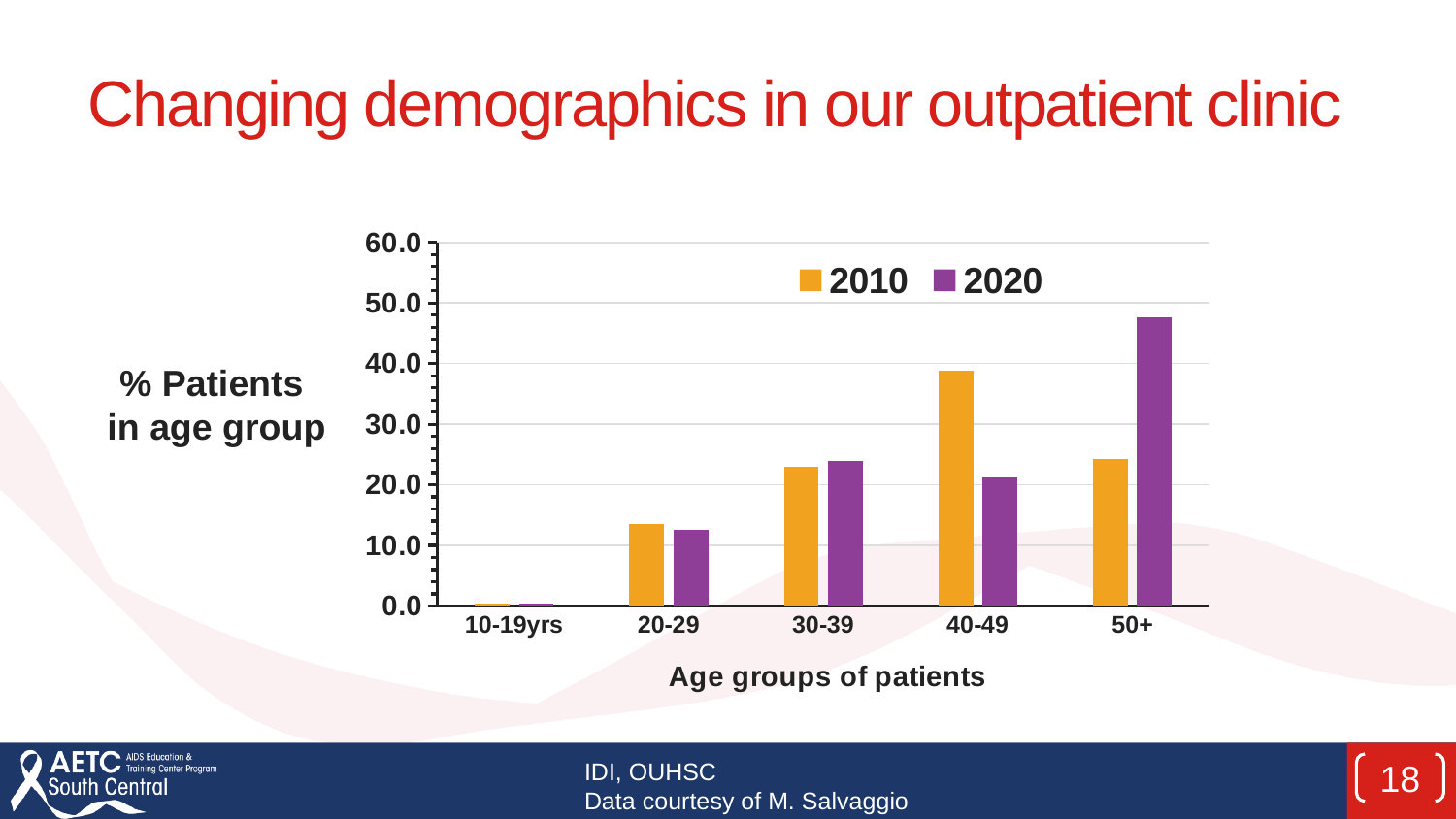
Is the 2020 value for the 40-49 age group greater or less than 30? less For the 50+ age group, which series has the larger value, 2010 or 2020? 2020 Is the 2020 value for the 50+ age group greater or less than 40? greater What is the label of the x axis? Age groups of patients Which age group has the lowest value for 2020? 10-19yrs Is the 2010 value for the 40-49 age group greater or less than 30? greater Which age group has the highest value for 2020? 50+ Which age group has the highest value for 2010? 40-49 How many age groups are shown on the x axis? 5 What kind of chart is shown on the slide? bar chart How many series does the legend list? 2 For the 40-49 age group, which series has the larger value, 2010 or 2020? 2010